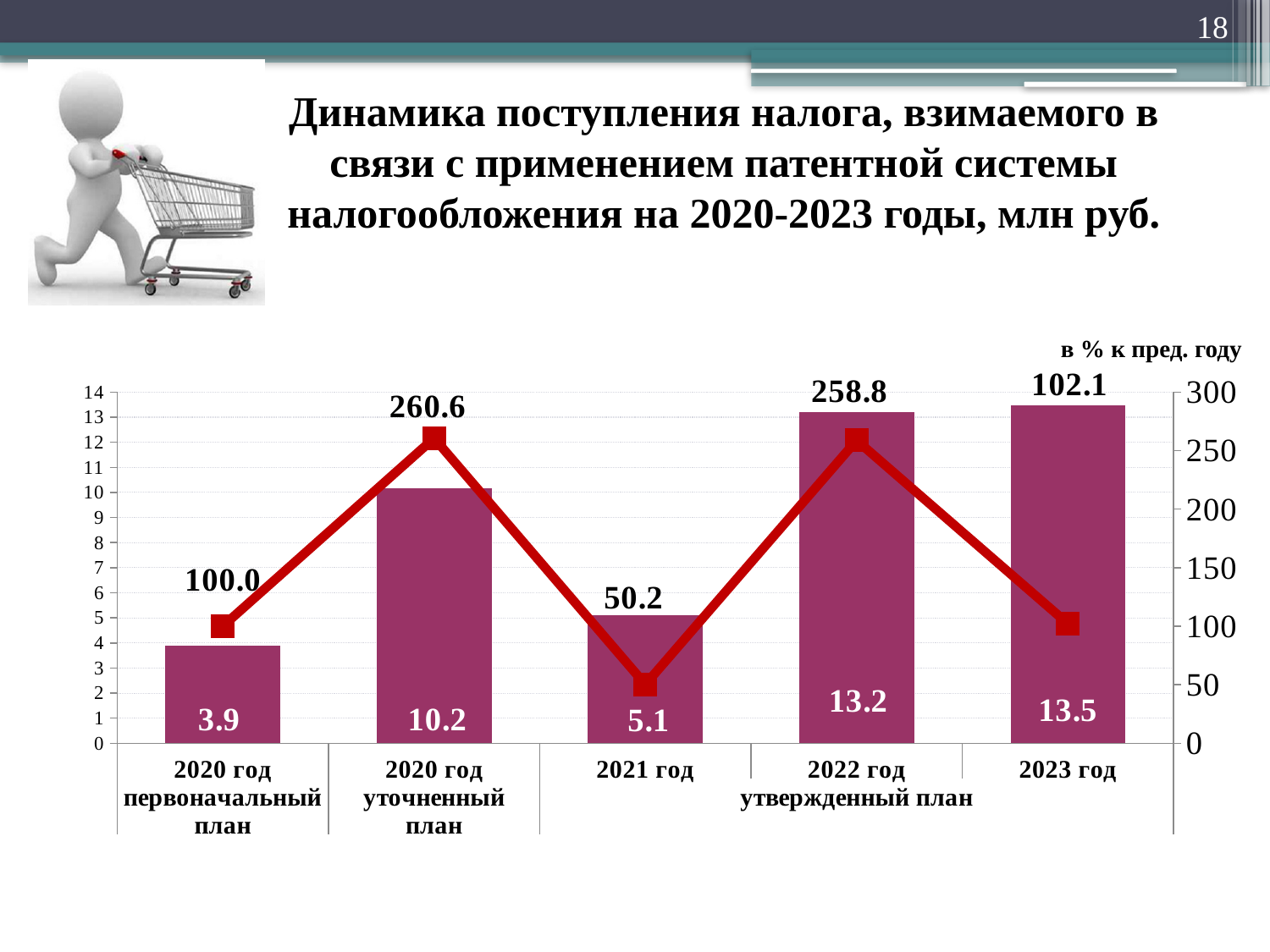
Which is larger, the bar value for 2022 год or for 2021 год? 2022 год What kind of chart is this? Combined bar and line chart Which category has the highest bar value? 2023 год What is the label of the right-hand axis? в % к пред. году What is the bar value for 2020 год уточненный план? 10.2 What is the difference between the bar values for 2020 год уточненный план and 2020 год первоначальный план? 6.3 How many categories are shown on the x axis? 5 What is the line value (в % к пред. году) for 2022 год? 258.8 Which category has the lowest bar value? 2020 год первоначальный план What is the line value (в % к пред. году) for 2023 год? 102.1 Which category has the lowest line value (в % к пред. году)? 2021 год What is the bar value for 2021 год? 5.1